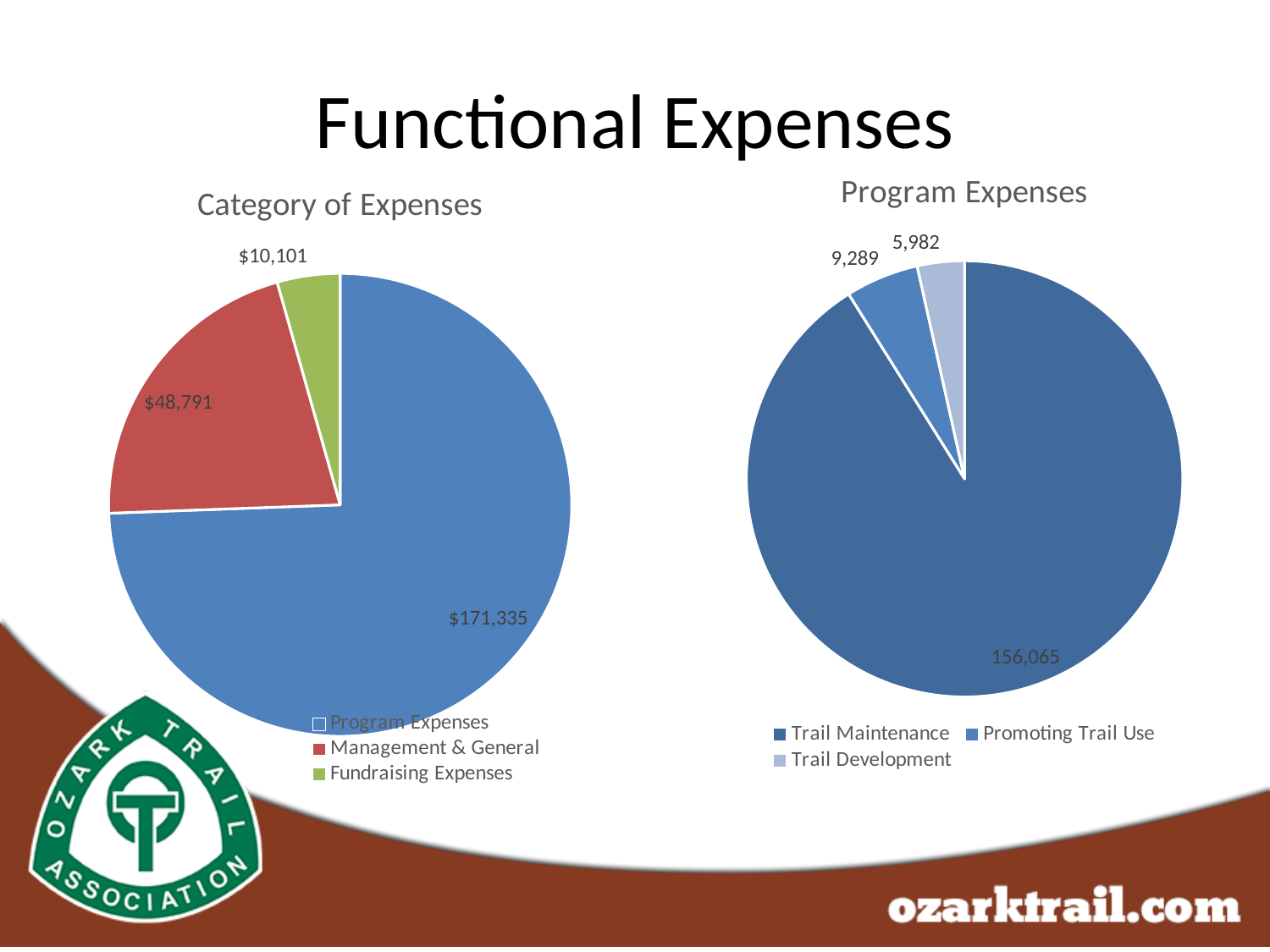
In the Category of Expenses chart, which category has the largest value? Program Expenses In the Program Expenses chart, what is the value for Trail Maintenance? 156,065 What kind of chart is the Program Expenses chart? Pie chart In the Program Expenses chart, which category has the smallest value? Trail Development How many categories does the Category of Expenses chart show? 3 In the Category of Expenses chart, what is the difference between Management & General and Fundraising Expenses? $38,690 In the Category of Expenses chart, what is the value for Fundraising Expenses? $10,101 In the Program Expenses chart, what is the value for Promoting Trail Use? 9,289 In the Program Expenses chart, what is the difference between Promoting Trail Use and Trail Development? 3,307 In the Category of Expenses chart, what is the value for Program Expenses? $171,335 In the Program Expenses chart, which is larger, Promoting Trail Use or Trail Development? Promoting Trail Use In the Category of Expenses chart, what is the value for Management & General? $48,791